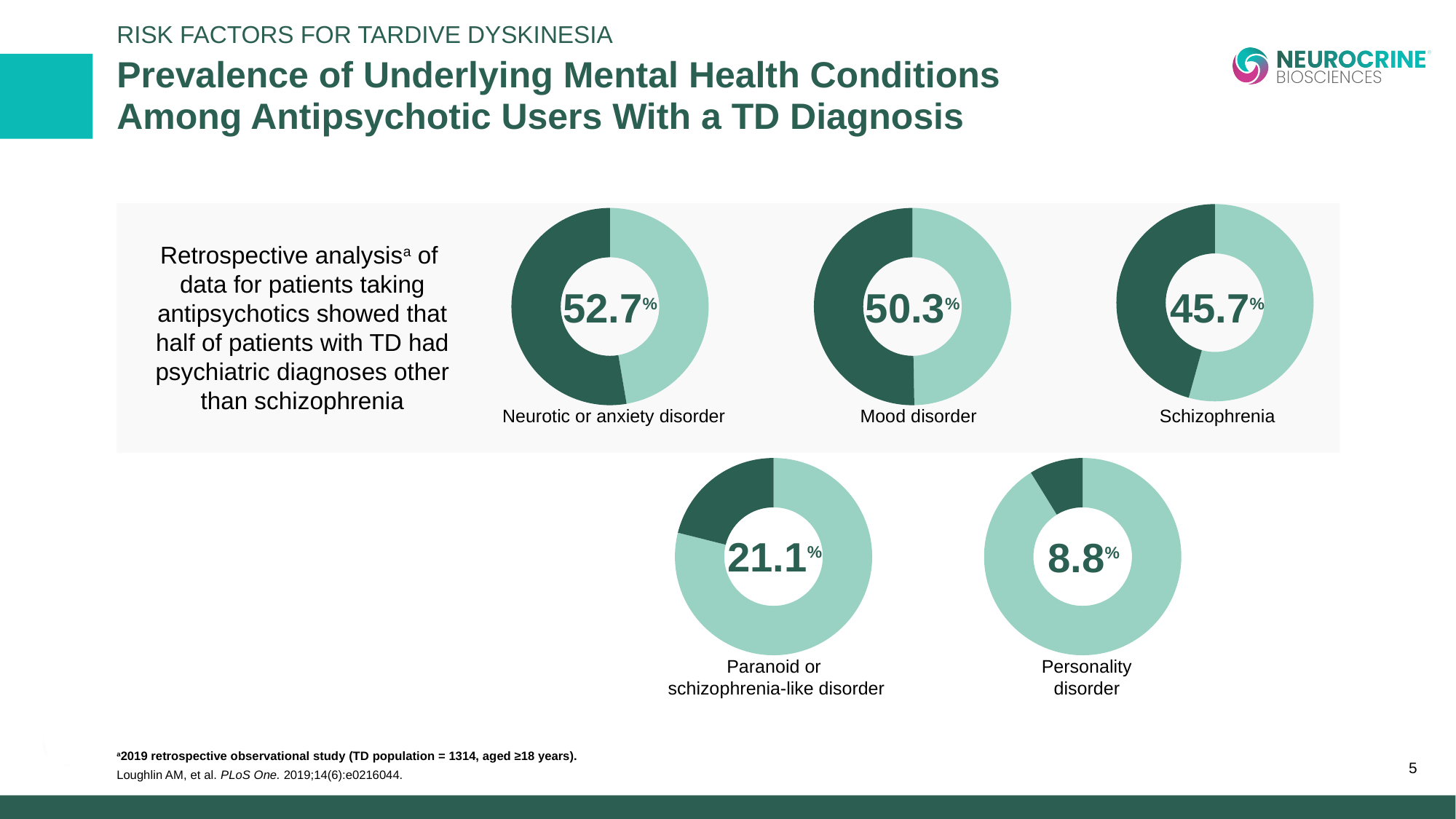
What percentage is shown in the Personality disorder donut chart? 8.8% Across the five donut charts, which condition has the lowest prevalence? Personality disorder What percentage is shown in the Schizophrenia donut chart? 45.7% What percentage is shown in the Paranoid or schizophrenia-like disorder donut chart? 21.1% What percentage is shown in the Mood disorder donut chart? 50.3% What percentage is shown in the Neurotic or anxiety disorder donut chart? 52.7% Which is larger: the percentage in the Mood disorder chart or the percentage in the Schizophrenia chart? Mood disorder What is the difference between the percentage in the Paranoid or schizophrenia-like disorder chart and the percentage in the Personality disorder chart? 12.3% How many donut charts are shown on the slide? 5 What kind of chart is used to show the prevalence of each condition on the slide? Donut (pie) chart What is the difference between the percentage in the Neurotic or anxiety disorder chart and the percentage in the Schizophrenia chart? 7.0% Across the five donut charts, which condition has the highest prevalence? Neurotic or anxiety disorder